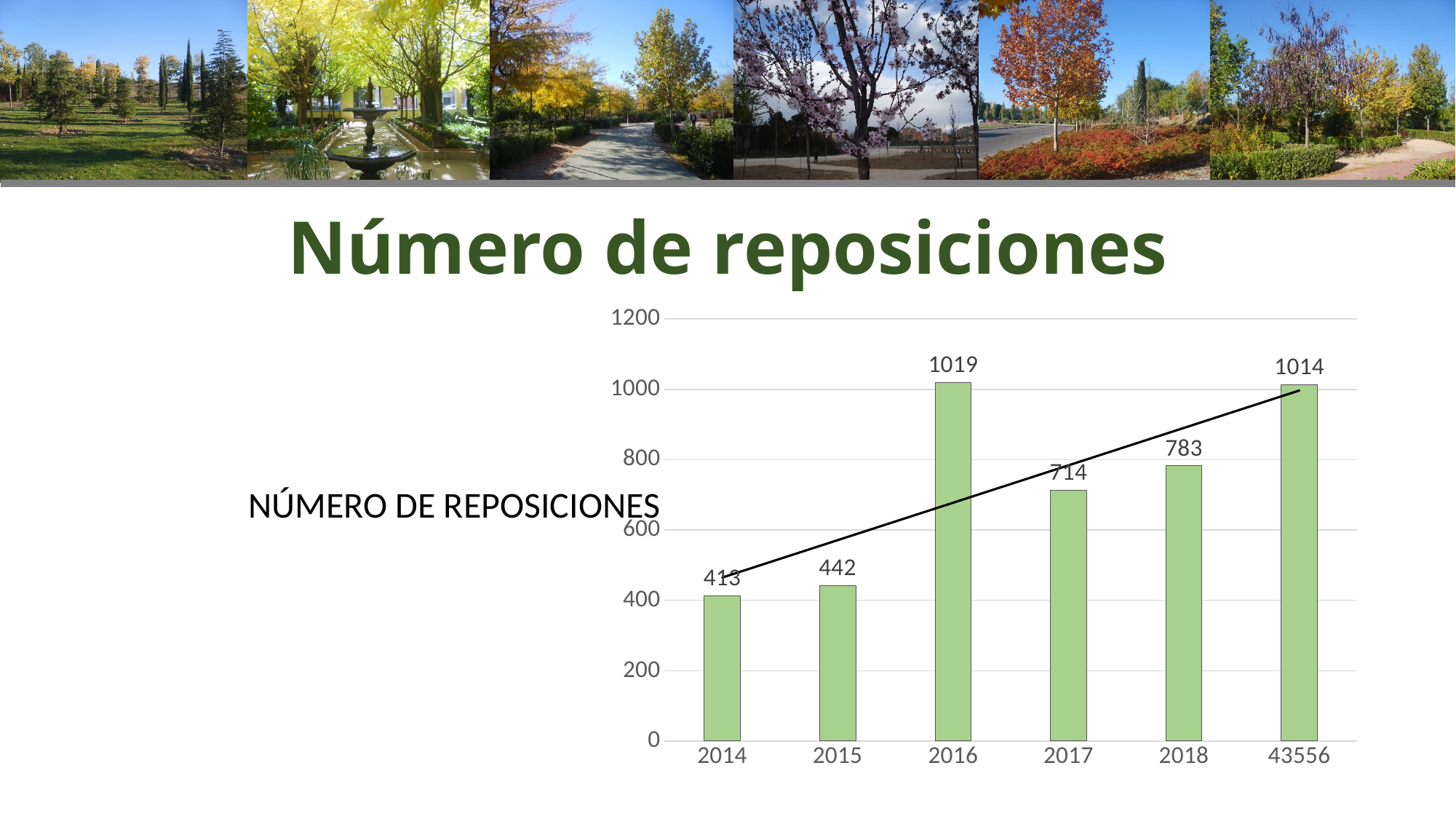
What is the value for 2018? 783 What is the value for 2016? 1019 Which category has the lowest value? 2014 How many bars are shown in the chart? 6 What is the value for 2014? 413 What is the difference between the values for 2016 and 2014? 606 Which is larger, the value for 2015 or the value for 2017? 2017 What is the difference between the values for 2018 and 2017? 69 Which category has the highest value? 2016 What kind of chart is shown on the slide? Bar chart What is the value for the category labelled 43556? 1014